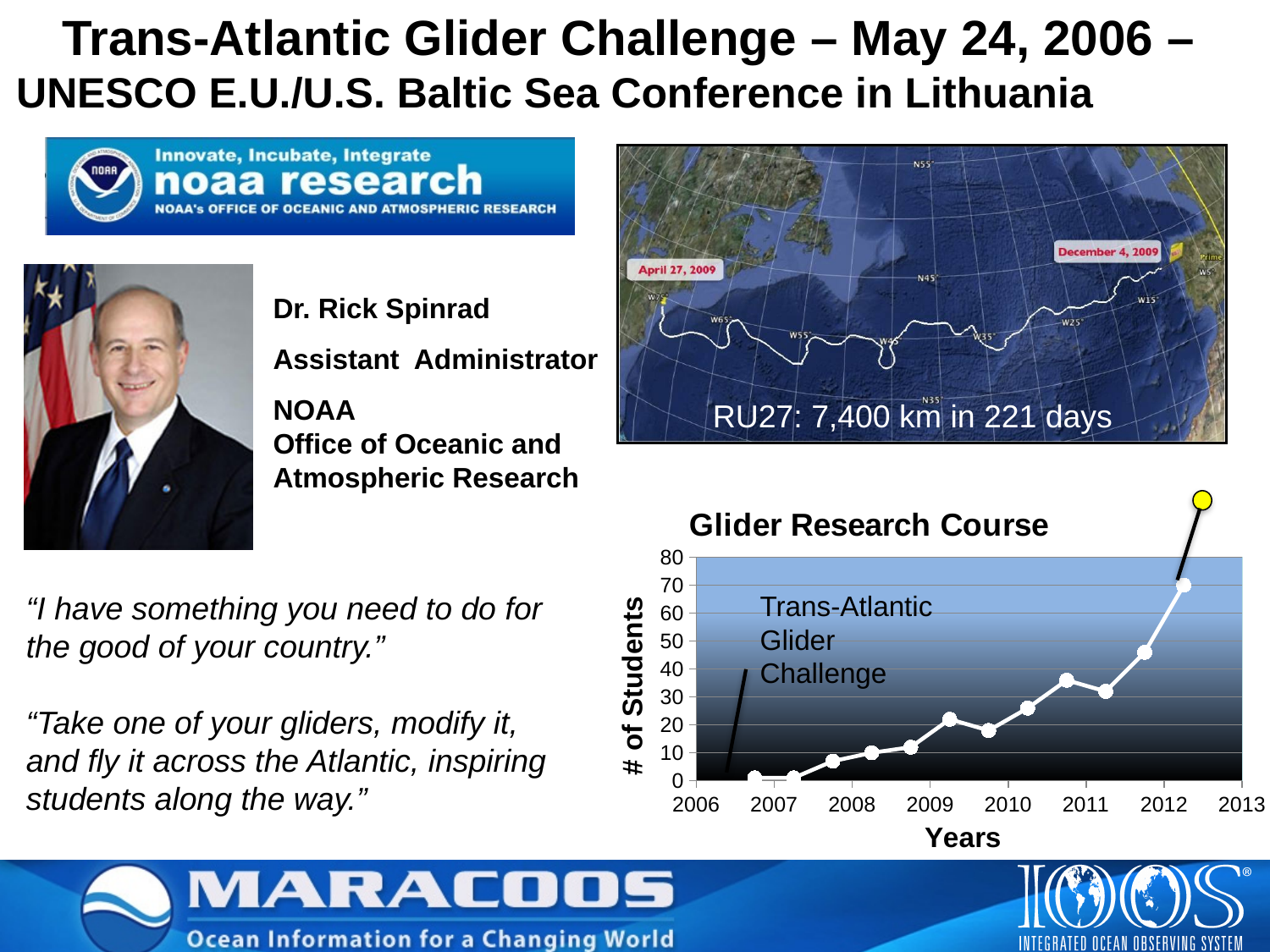
In the "Glider Research Course" chart, is the value of the last (highest) data point, just after 2012, greater or less than 60? greater In the "Glider Research Course" chart, is the value of the data point just before 2011 greater or less than 30? greater In the "Glider Research Course" chart, do the values generally rise or fall from 2006 to 2013? rise In the "Glider Research Course" chart, is the value of the data point just after 2010 greater or less than 30? less What kind of chart is the "Glider Research Course" chart? line chart What is the title of the chart at the bottom right of the slide? Glider Research Course In the "Glider Research Course" chart, what is the highest value shown on the y-axis? 80 How many data points are plotted on the "Glider Research Course" chart? 12 What is the label on the y-axis of the "Glider Research Course" chart? # of Students In the "Glider Research Course" chart, which data point has the highest number of students: the one just after 2012 or the one just before 2012? the one just after 2012